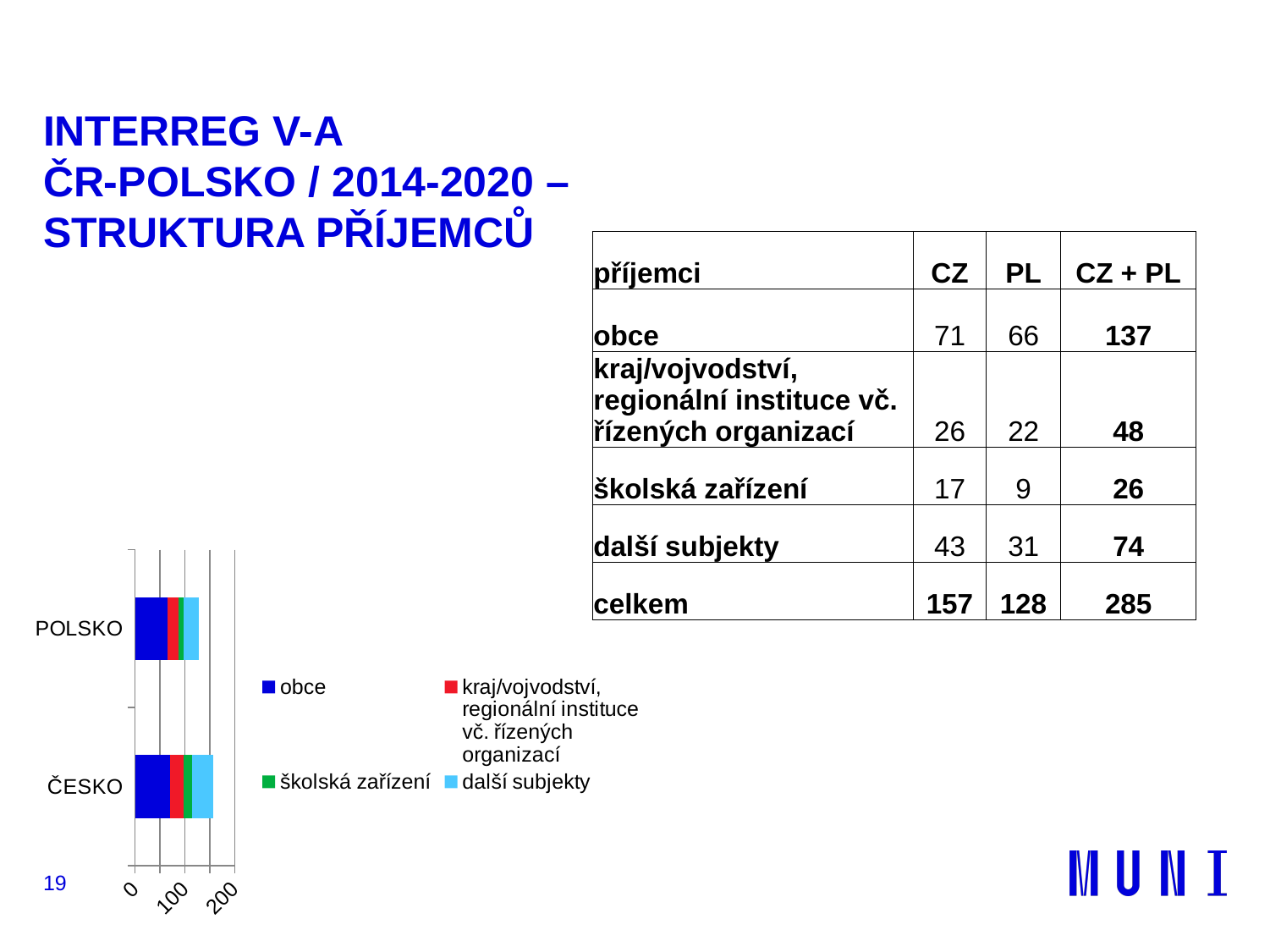
Which legend entry is shown in dark blue? obce Which legend entry is shown in light blue? další subjekty How many series does the chart legend list? 4 Which category has the longest bar in the chart? ČESKO Which category has the longer stacked bar, ČESKO or POLSKO? ČESKO Is the total length of the ČESKO bar greater or less than 100? greater Is the total length of the POLSKO bar greater or less than 200? less Is the 'obce' segment of the POLSKO bar greater or less than 100? less How many categories (bars) does the chart show? 2 According to the table on the slide, what is the total (celkem) number of recipients for CZ? 157 Which category has the shortest bar in the chart? POLSKO What kind of chart is shown on the slide? stacked bar chart